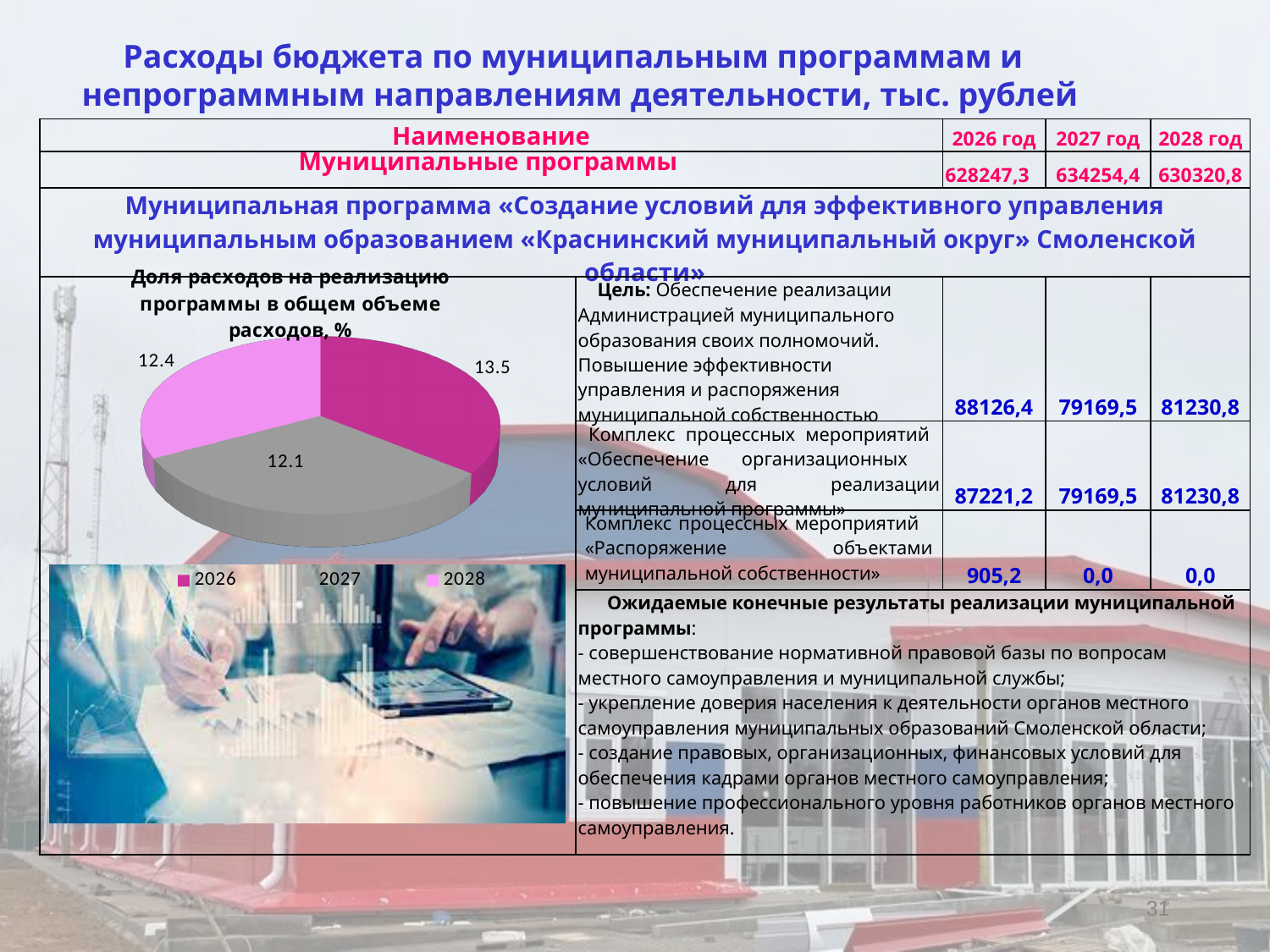
What is the value for 2026 in the pie chart? 13.5 What is the value for 2027 in the pie chart? 12.1 What is the title of the pie chart? Доля расходов на реализацию программы в общем объеме расходов, % How many entries does the legend of the pie chart list? 3 What is the difference between the values for 2026 and 2027 in the pie chart? 1.4 What type of chart is shown on the slide? pie chart Which is larger in the pie chart, the value for 2026 or the value for 2028? 2026 Which year has the smallest slice in the pie chart? 2027 What is the value for 2028 in the pie chart? 12.4 Which year has the largest slice in the pie chart? 2026 What is the difference between the values for 2028 and 2027 in the pie chart? 0.3 How many slices does the pie chart have? 3